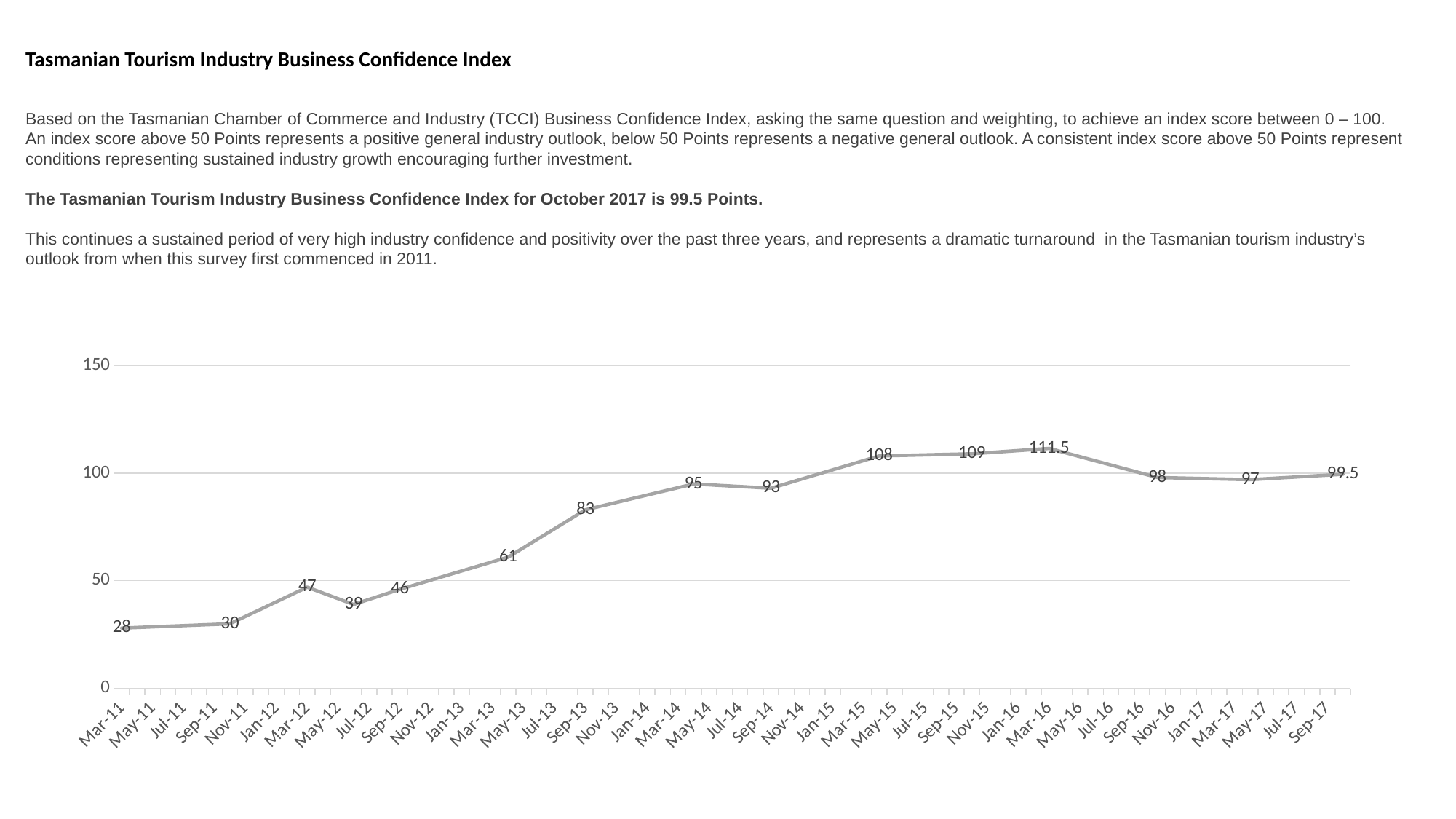
What kind of chart is shown on the slide? line chart What is the lowest value labelled on the line chart? 28 How many data points are labelled with values on the line chart? 15 What is the highest value labelled on the line chart? 111.5 What is the difference between the labelled values 83 and 61 on the line chart? 22 What is the value of the last data point on the line chart (at Sep-17)? 99.5 What is the highest tick value shown on the y axis? 150 Which is larger, the point labelled 95 or the point labelled 93? 95 Overall, does the index rise or fall from Mar-11 to Sep-17? rise What is the value of the first data point on the line chart (at Mar-11)? 28 What is the difference between the highest labelled value (111.5) and the final value (99.5)? 12 Is the value of the last data point (Sep-17) greater or less than 50? greater